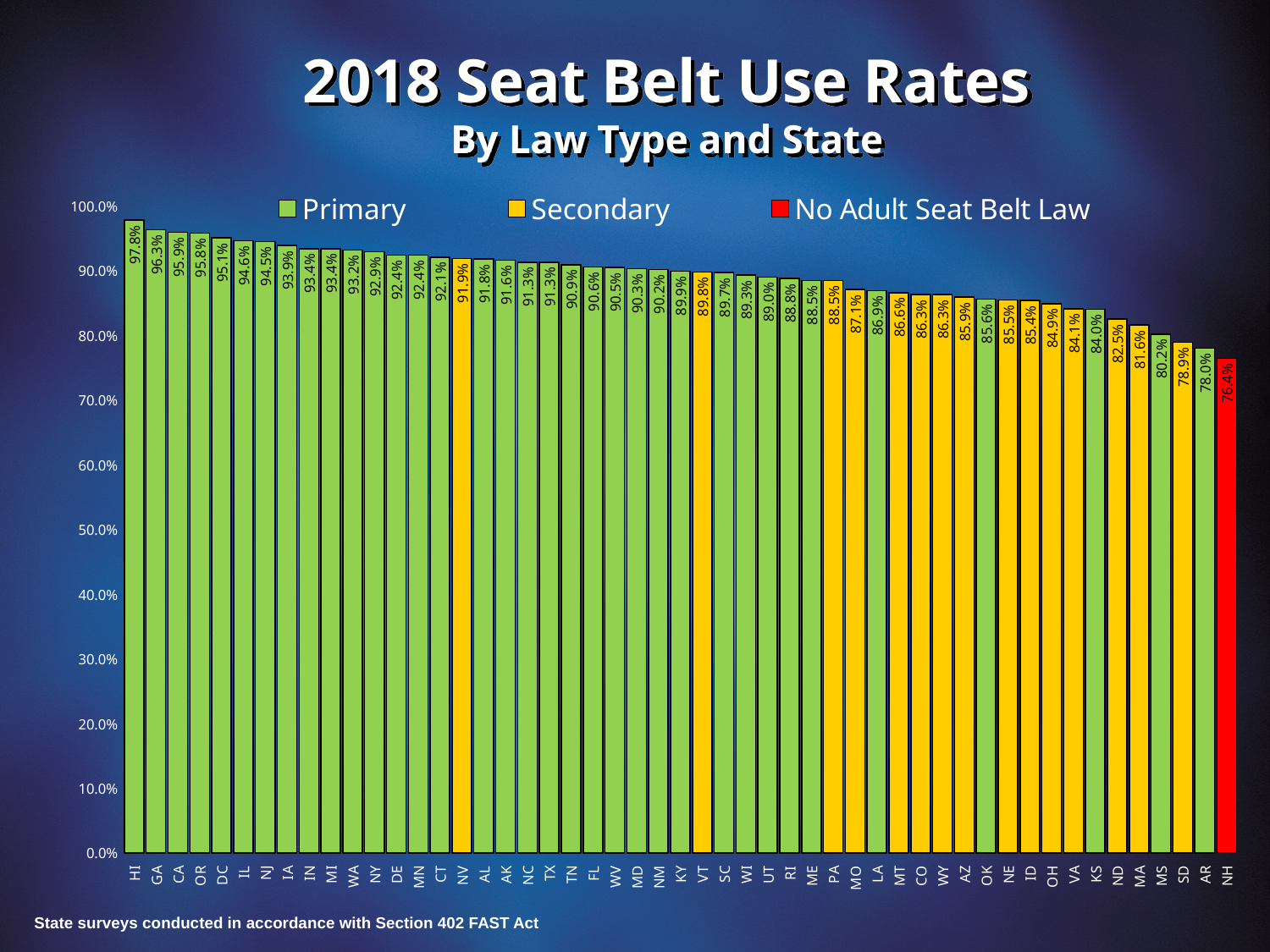
What kind of chart is shown on the slide? Bar chart Which state has the highest seat belt use rate? HI How many states/jurisdictions are shown on the x axis? 51 What is the seat belt use rate for HI? 97.8% What is the difference between the seat belt use rates of HI and NH? 21.4% How many series does the legend list? 3 Do the seat belt use rates rise or fall from left to right along the x axis? Fall Which has a higher seat belt use rate, GA or AR? GA Which state has the lowest seat belt use rate? NH What is the seat belt use rate for TX? 91.3% What is the seat belt use rate for NH? 76.4% Is the value for SD greater or less than 90.0%? less